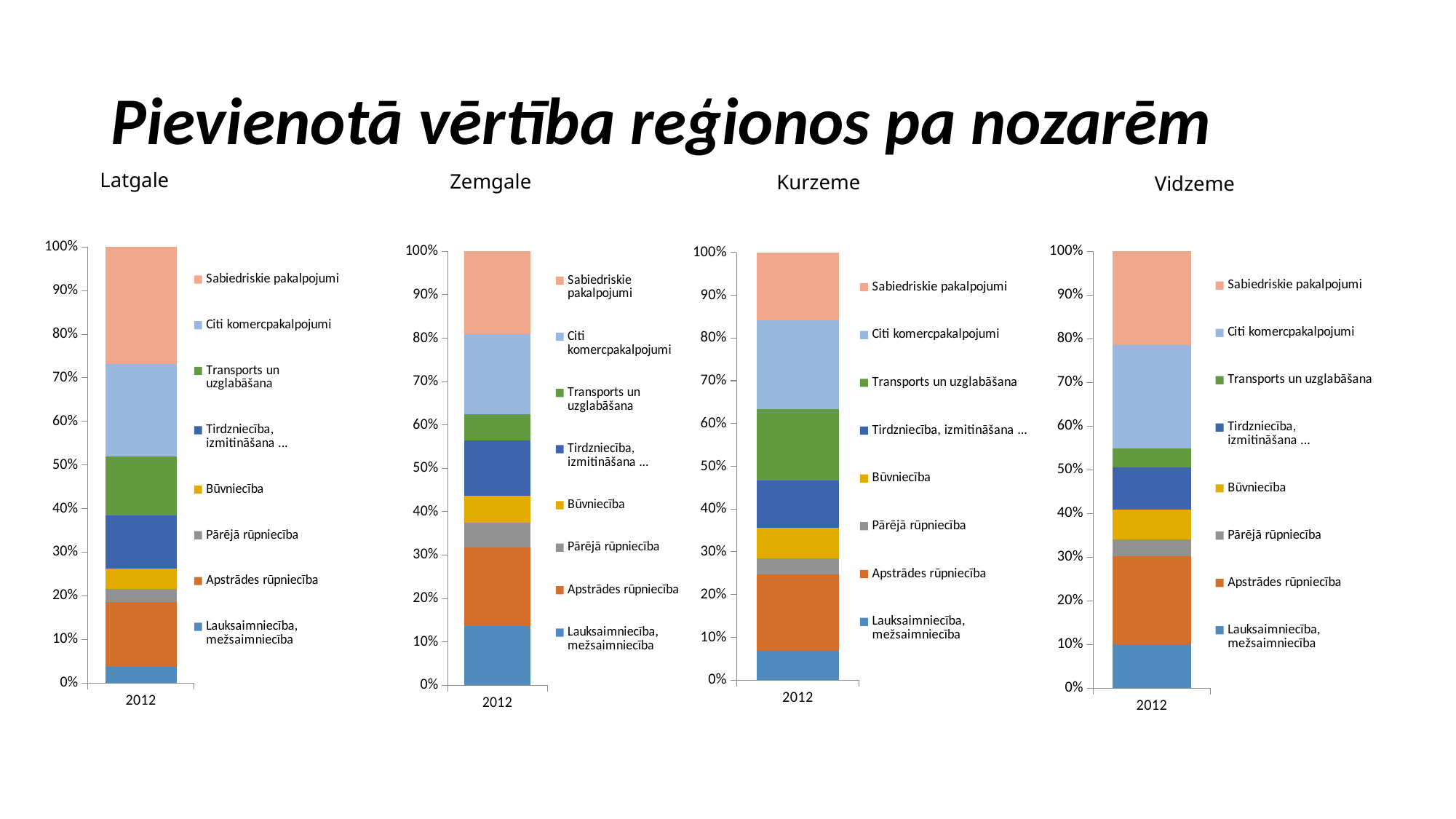
In the Zemgale chart, is the value for Lauksaimniecība, mežsaimniecība greater or less than 10%? greater How many series does the legend of the Zemgale chart list? 8 Which region has the larger share for Sabiedriskie pakalpojumi, Latgale or Kurzeme? Latgale In the Latgale chart, which sector has the largest share? Sabiedriskie pakalpojumi In the Latgale chart, is the value for Lauksaimniecība, mežsaimniecība greater or less than 10%? less What kind of chart is the Latgale chart? stacked bar chart In the Vidzeme chart, is the value for Apstrādes rūpniecība greater or less than 10%? greater Which year is shown on the x axis of the Vidzeme chart? 2012 How many categories are shown on the x axis of the Kurzeme chart? 1 In the Vidzeme chart, which sector has the largest share? Citi komercpakalpojumi